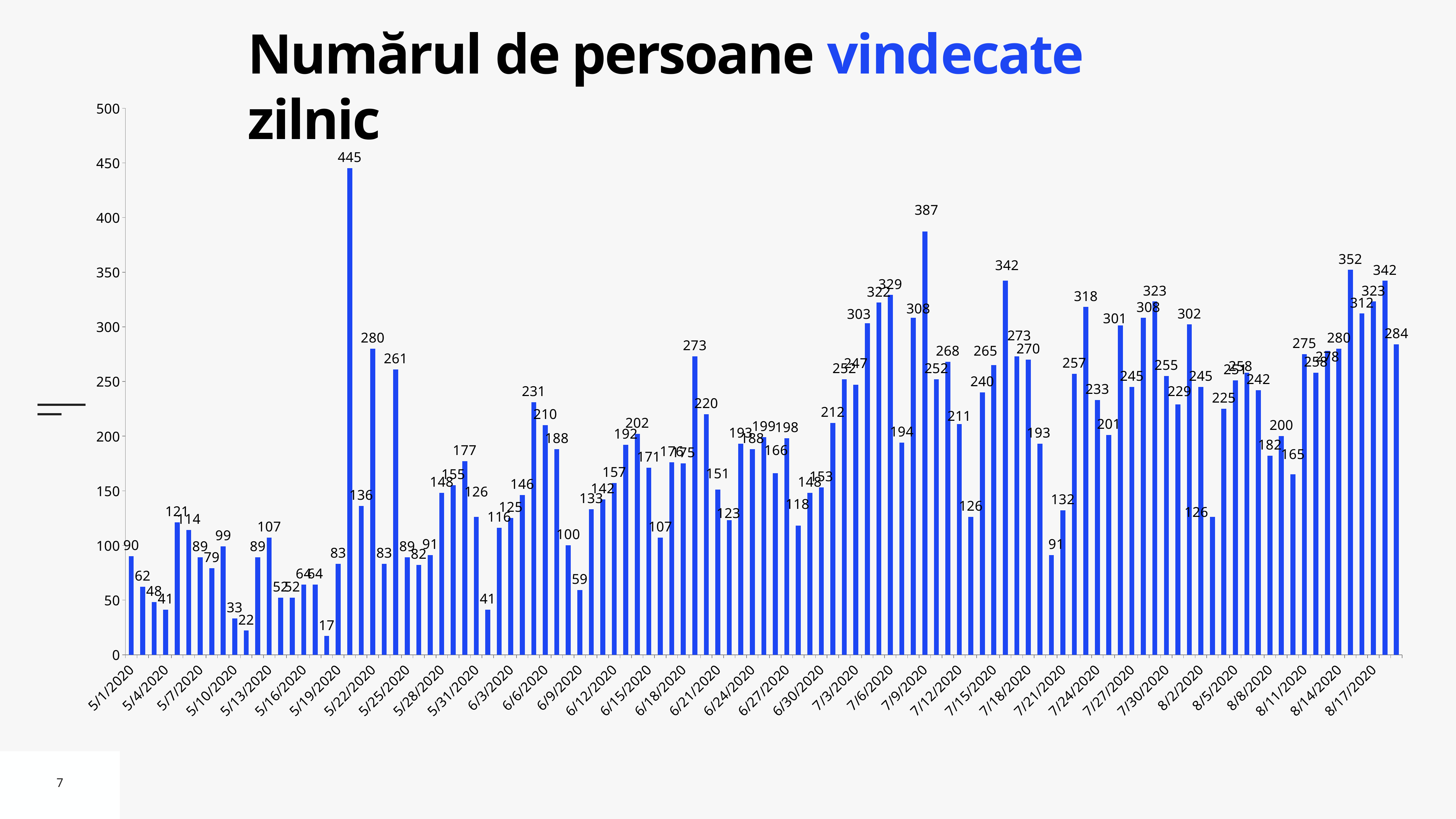
Which is larger, the bar labelled 445 or the bar labelled 387? 445 Is the value for 5/1/2020 greater or less than 100? less What is the maximum value shown on the vertical axis? 500 What kind of chart is shown on the slide? bar chart What is the difference between the highest value (445) and the lowest value (17)? 428 What is the lowest daily value shown in the chart? 17 What is the difference between the two tallest bars, 445 and 387? 58 Overall, do the daily values tend to rise or fall from May to August? rise What is the title of the chart on the slide? Numărul de persoane vindecate zilnic What is the value for 5/4/2020? 41 What is the highest daily value shown in the chart? 445 What is the value for 5/1/2020? 90